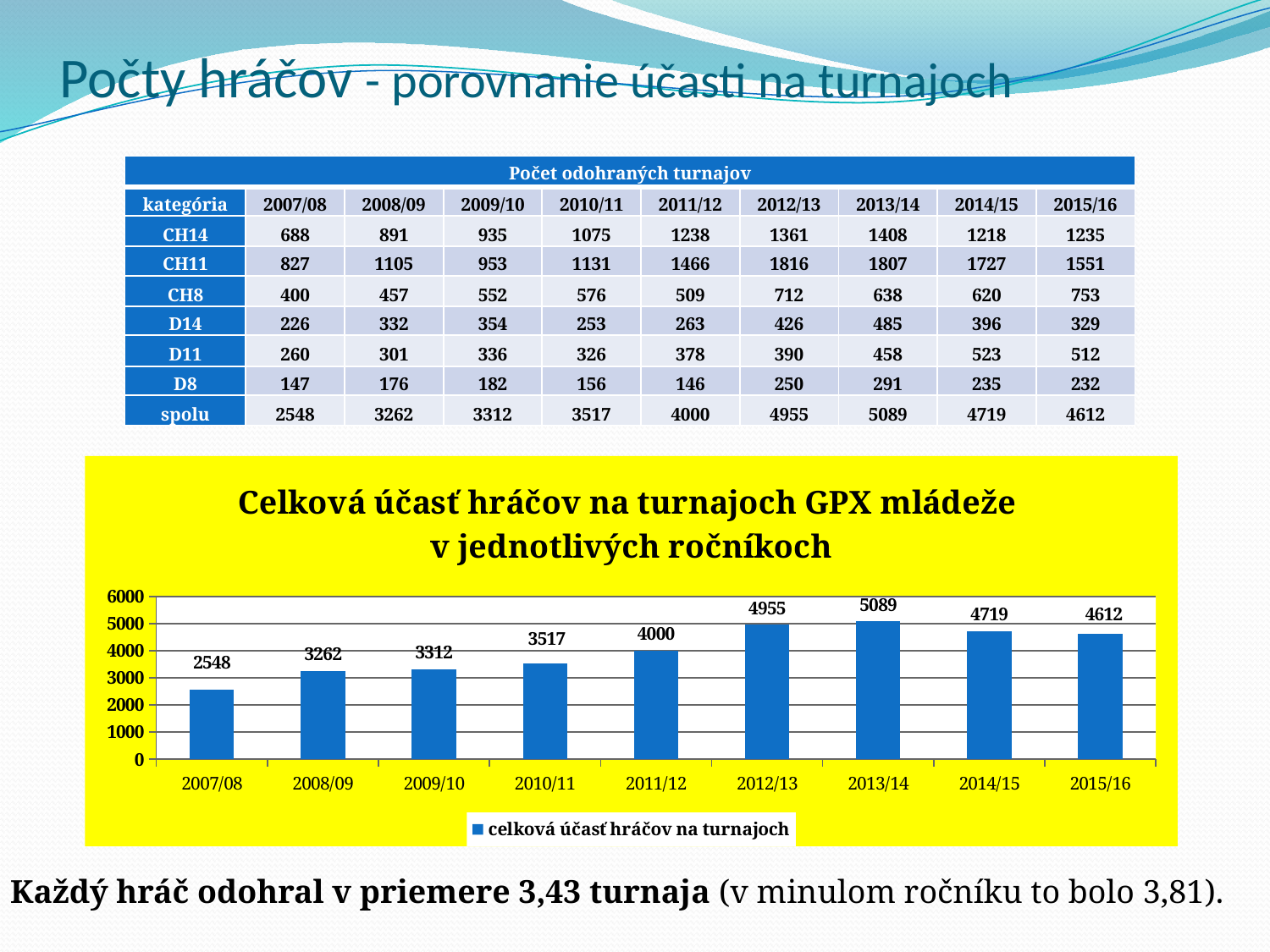
What is the value for 2011/12 in the chart? 4000 What is the difference between the values for 2014/15 and 2015/16? 107 Which season has the highest value in the chart? 2013/14 Which season has the lowest value in the chart? 2007/08 What is the difference between the values for 2013/14 and 2012/13? 134 What is the title of the chart? Celková účasť hráčov na turnajoch GPX mládeže v jednotlivých ročníkoch Is the value for 2012/13 greater or less than 4000? greater What kind of chart is shown on the slide? bar chart Which is larger, the value for 2009/10 or the value for 2010/11? 2010/11 What is the value for 2007/08 in the chart? 2548 How many seasons are shown on the x axis of the chart? 9 What is the value for 2015/16 in the chart? 4612